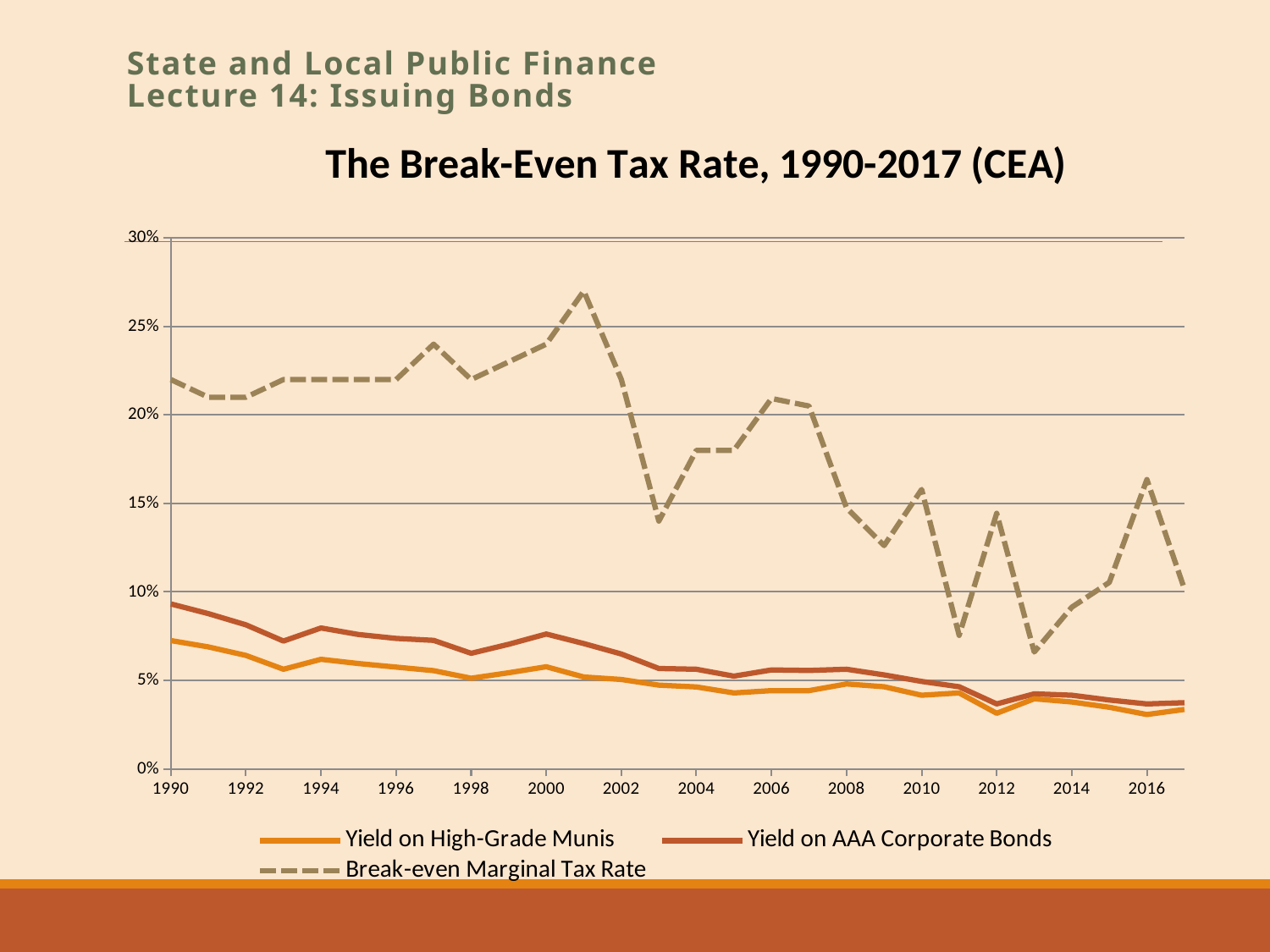
Is the Yield on High-Grade Munis in 2016 greater or less than 5%? less Does the Yield on AAA Corporate Bonds generally rise or fall from 1990 to 2017? Fall Is the Yield on AAA Corporate Bonds in 1990 greater or less than 5%? greater What is the title of the chart? The Break-Even Tax Rate, 1990-2017 (CEA) How many series does the legend list? 3 In 1990, which is larger: the Yield on AAA Corporate Bonds or the Yield on High-Grade Munis? Yield on AAA Corporate Bonds Which series is drawn with a dashed line? Break-even Marginal Tax Rate What kind of chart is shown on the slide? Line chart In which year does the Break-even Marginal Tax Rate reach its highest value? 2001 Is the Break-even Marginal Tax Rate in 2013 greater or less than 10%? less Which is larger: the Break-even Marginal Tax Rate in 2001 or in 2003? 2001